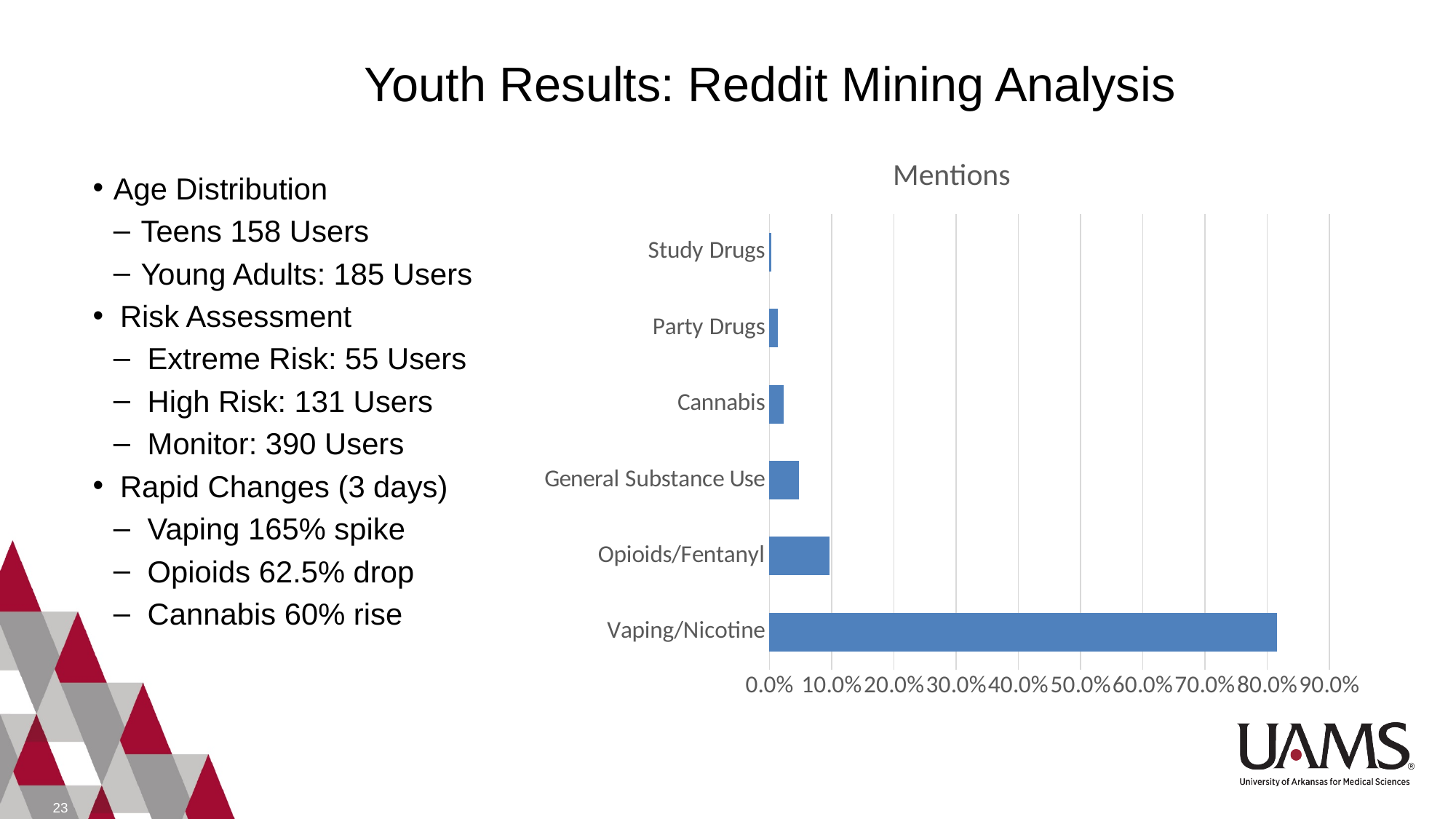
Which category has the lowest value in the chart? Study Drugs How many categories are plotted in the chart? 6 Is the value for Vaping/Nicotine greater or less than 70.0%? greater Which category has the highest value in the chart? Vaping/Nicotine Is the value for Opioids/Fentanyl greater or less than 20.0%? less What is the title of the chart? Mentions Which is larger, the value for Opioids/Fentanyl or the value for Cannabis? Opioids/Fentanyl Which is larger, the value for General Substance Use or the value for Party Drugs? General Substance Use Which category is listed at the bottom of the chart? Vaping/Nicotine Is the value for General Substance Use greater or less than 10.0%? less What kind of chart is shown on the slide? bar chart